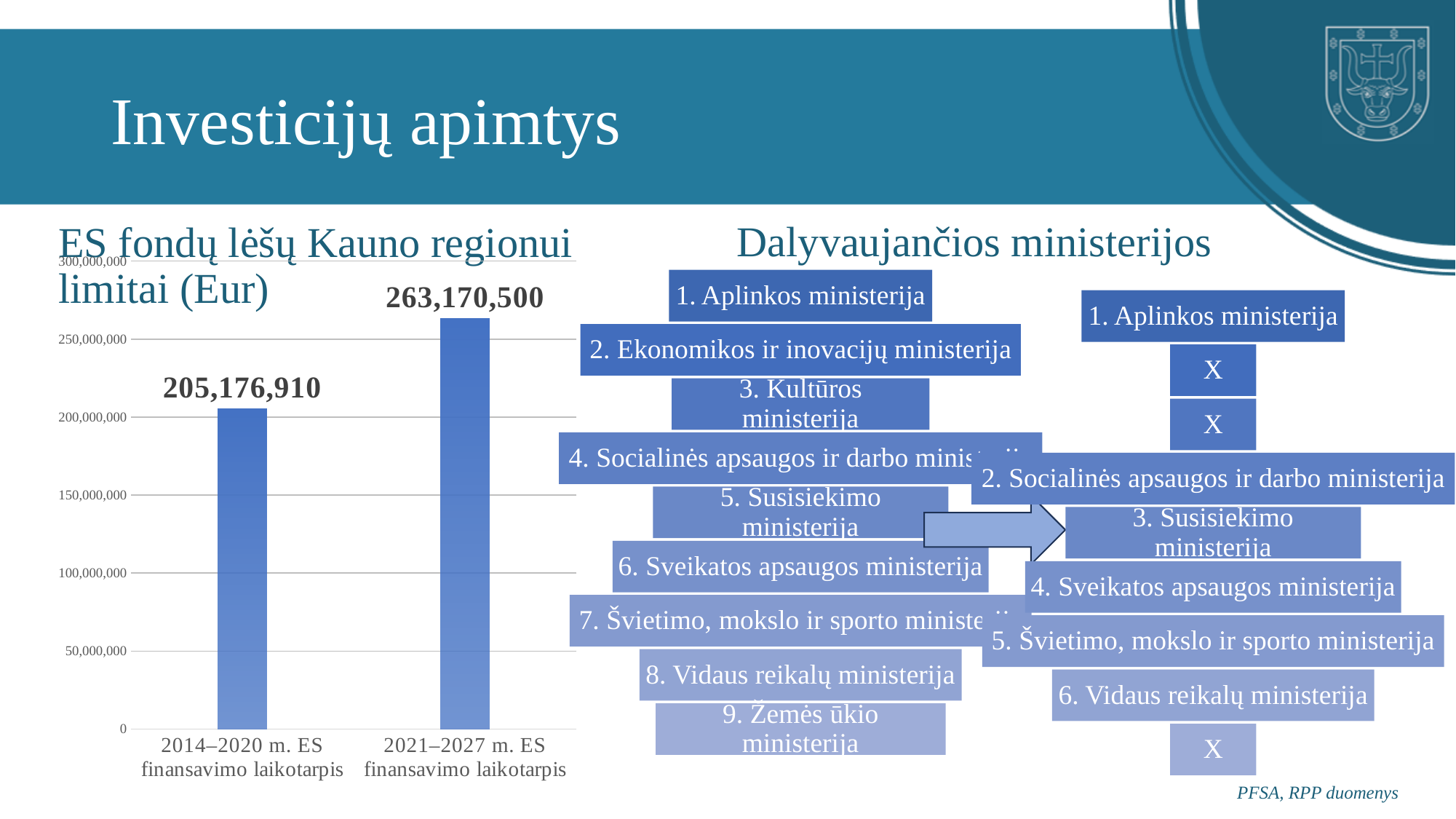
Is the value for 2014–2020 m. ES finansavimo laikotarpis larger or smaller than the value for 2021–2027 m. ES finansavimo laikotarpis? smaller What is the difference between the 2021–2027 and 2014–2020 values? 57,993,590 How many bars are shown in the chart? 2 Is the value for 2014–2020 m. ES finansavimo laikotarpis greater or less than 250,000,000? less What is the value for the 2021–2027 m. ES finansavimo laikotarpis bar? 263,170,500 Do the values rise or fall from the 2014–2020 period to the 2021–2027 period? rise What type of chart is shown on the slide? bar chart Is the value for 2021–2027 m. ES finansavimo laikotarpis greater or less than 250,000,000? greater Which funding period has the higher limit? 2021–2027 m. ES finansavimo laikotarpis What is the title of the chart? ES fondų lėšų Kauno regionui limitai (Eur) What is the value for the 2014–2020 m. ES finansavimo laikotarpis bar? 205,176,910 Which funding period has the lower limit? 2014–2020 m. ES finansavimo laikotarpis